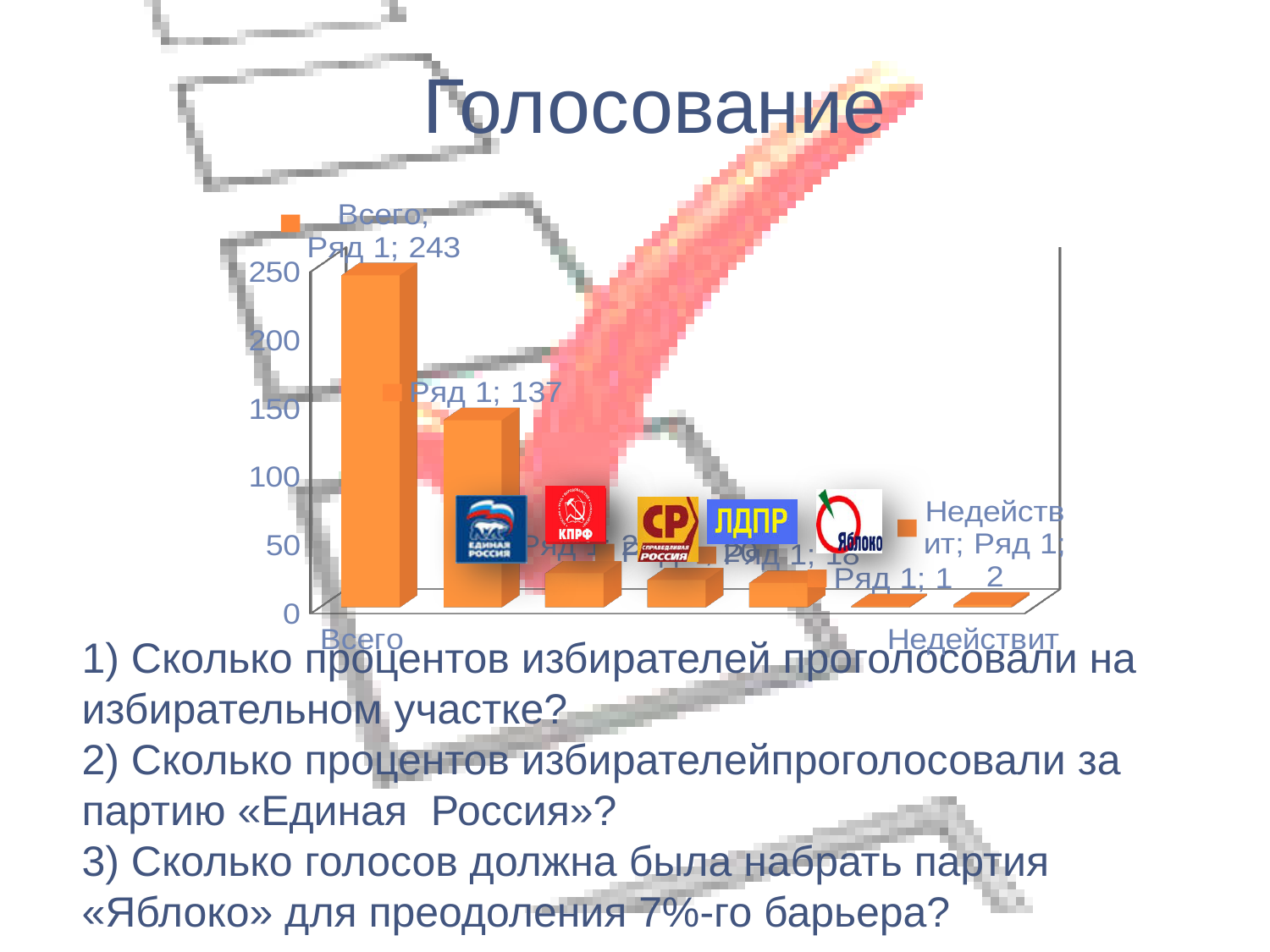
What is the difference between the values for Всего and Недействит? 241 What is the value of the second bar from the left? 137 Is the value of the second bar from the left greater or less than 100? greater How many bars are plotted on the chart? 7 What is the difference between the Всего bar (243) and the second bar (137)? 106 What is the value of the bar for Всего? 243 Which category has the highest bar? Всего What kind of chart is shown on the slide? bar chart What is the name of the data series shown in the data labels? Ряд 1 What is the value of the bar for Недействит? 2 Which is larger: the value for Всего or the value of the second bar from the left? Всего What is the highest tick value shown on the vertical axis? 250